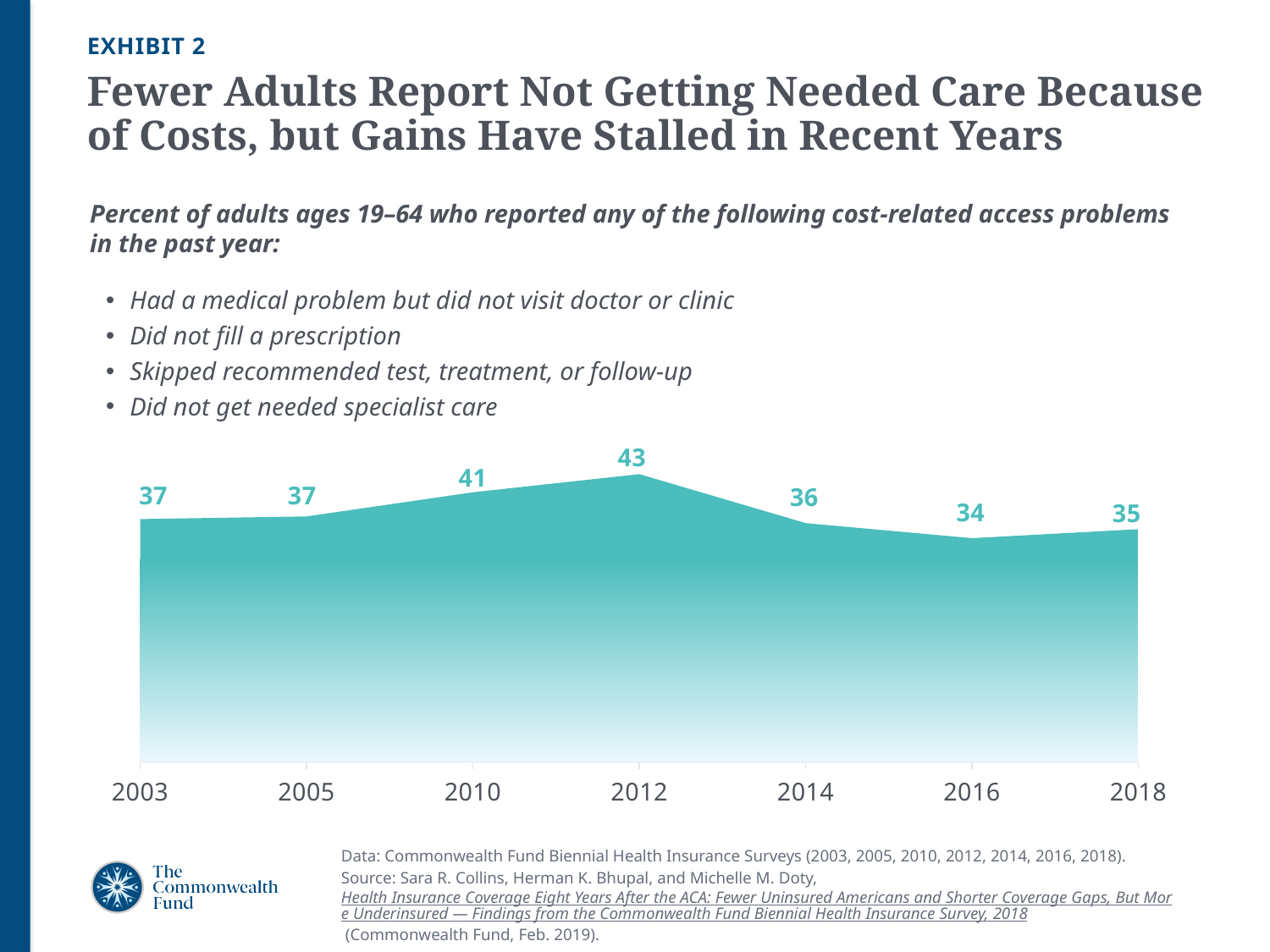
Which year has the lowest value? 2016 What is the difference between the values for 2012 and 2018? 8 What value is shown for 2018? 35 How many years are plotted on the chart? 7 Which year has the highest value? 2012 What value is shown for 2003? 37 What kind of chart is shown? Area chart What is the exhibit number shown above the chart title? Exhibit 2 Do the values rise or fall from 2012 to 2016? Fall What is the difference between the values for 2003 and 2010? 4 Which is larger, the value for 2014 or the value for 2016? 2014 What value is shown for 2012? 43